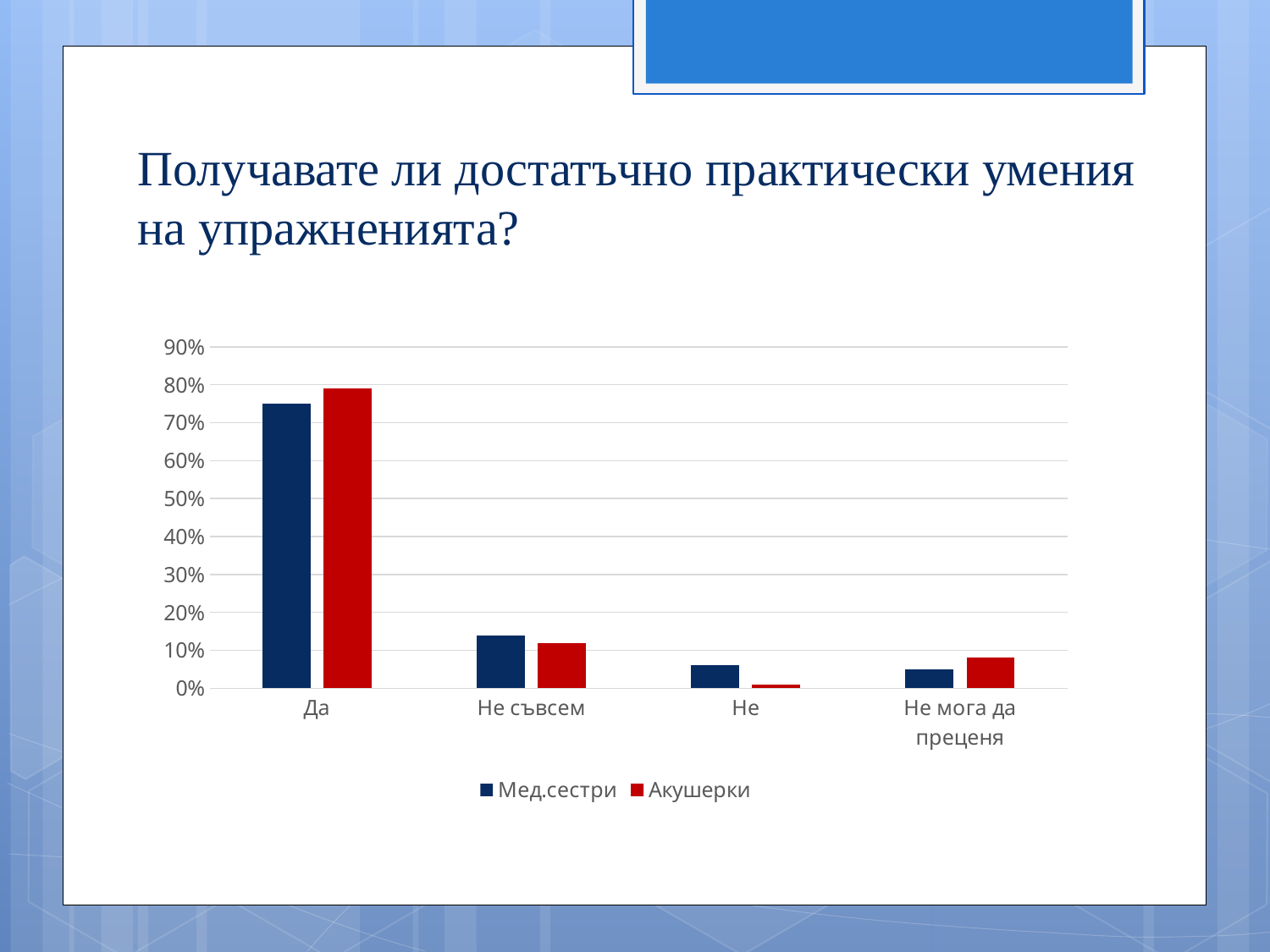
Which category has the highest value for Акушерки? Да In the Не category, which series has the larger value, Мед.сестри or Акушерки? Мед.сестри Which category has the lowest value for Акушерки? Не Is the value for Мед.сестри in the Не съвсем category greater or less than 10%? greater What kind of chart is shown on the slide? bar chart Is the value for Мед.сестри in the Да category greater or less than 70%? greater In the Да category, which series has the larger value, Мед.сестри or Акушерки? Акушерки How many categories are shown on the x axis? 4 How many series does the legend list? 2 Which category has the highest value for Мед.сестри? Да Is the value for Акушерки in the Не category greater or less than 10%? less